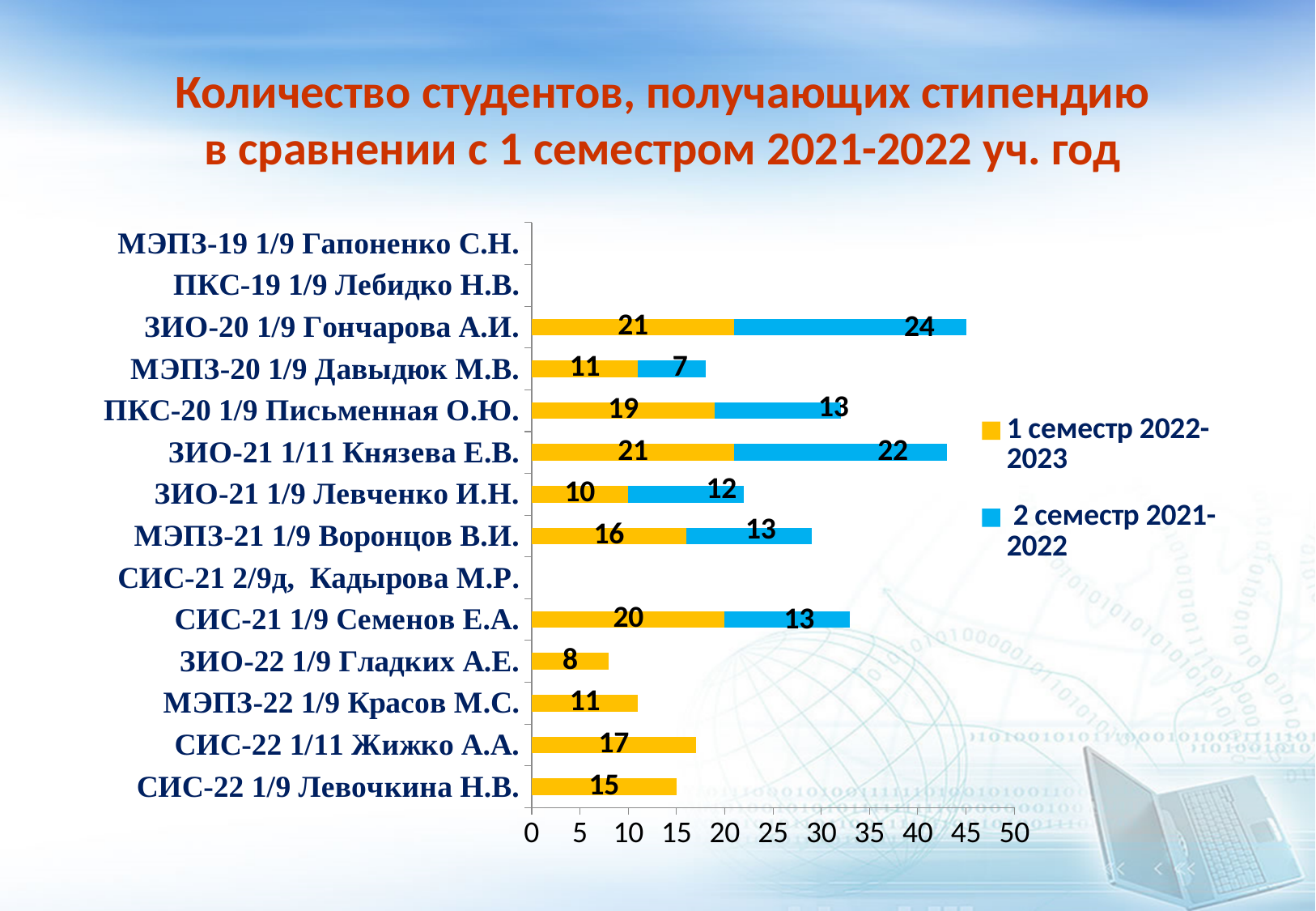
Which category has the lowest value in the 1 семестр 2022-2023 series among those with a bar? ЗИО-22 1/9 Гладких А.Е. What is the value for СИС-22 1/11 Жижко А.А. in the 1 семестр 2022-2023 series? 17 What is the value for ЗИО-20 1/9 Гончарова А.И. in the 1 семестр 2022-2023 series? 21 What kind of chart is shown on the slide? bar chart What is the difference between the 1 семестр 2022-2023 value and the 2 семестр 2021-2022 value for СИС-21 1/9 Семенов Е.А.? 7 What is the value for МЭПЗ-20 1/9 Давыдюк М.В. in the 2 семестр 2021-2022 series? 7 How many categories are listed on the vertical axis of the chart? 14 What is the total of the stacked bar for ПКС-20 1/9 Письменная О.Ю.? 32 How many series does the legend list? 2 Which is larger for ЗИО-21 1/9 Левченко И.Н.: the 1 семестр 2022-2023 value or the 2 семестр 2021-2022 value? 2 семестр 2021-2022 What is the total of the stacked bar for ЗИО-21 1/11 Князева Е.В.? 43 Which category has the highest value in the 2 семестр 2021-2022 series? ЗИО-20 1/9 Гончарова А.И.